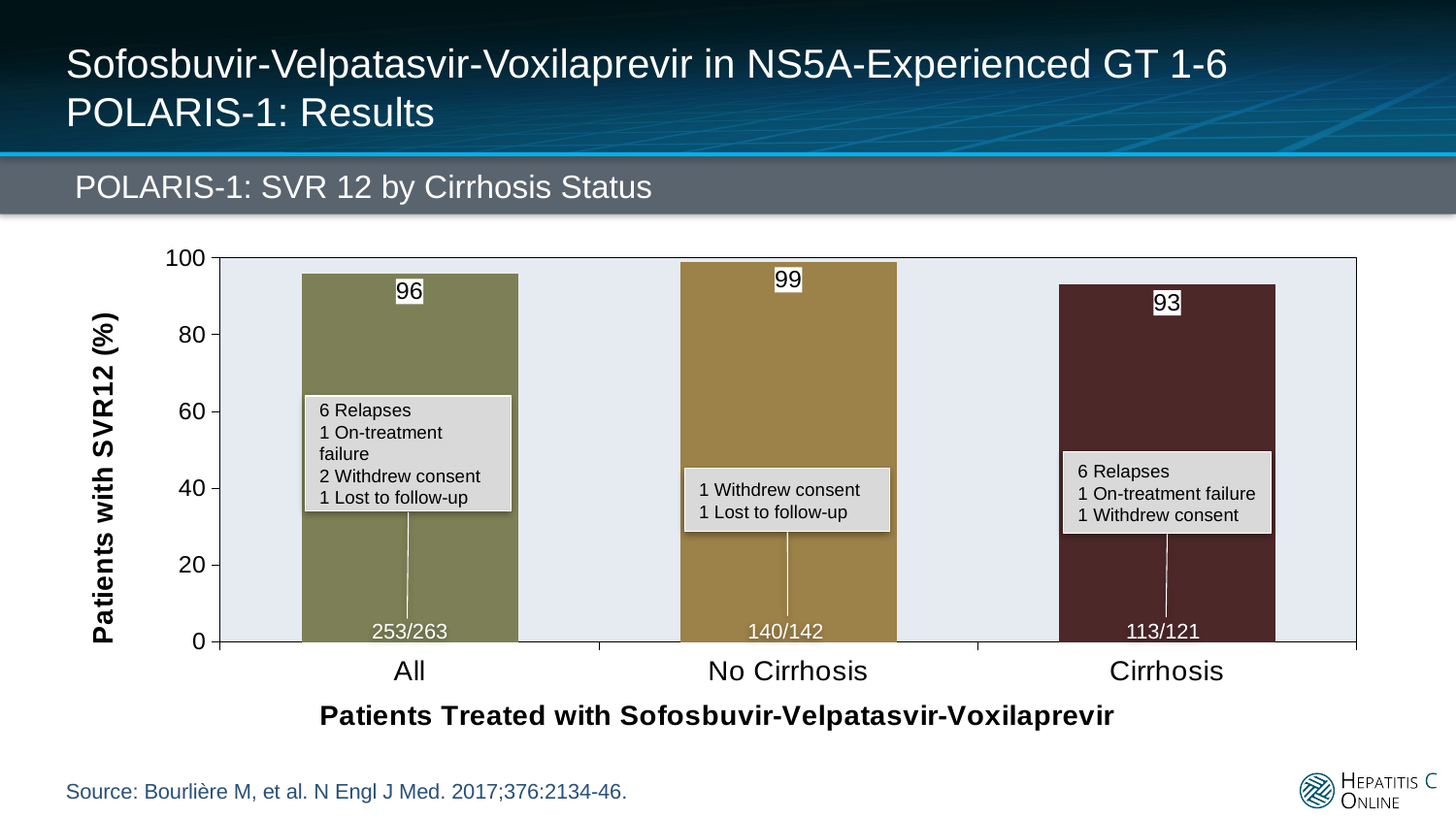
What is the difference in SVR12 rate between the No Cirrhosis and Cirrhosis groups? 6 What is the SVR12 rate for patients with No Cirrhosis? 99 What is the title of the chart? POLARIS-1: SVR 12 by Cirrhosis Status Which group has the lowest SVR12 rate? Cirrhosis What is the SVR12 rate for patients with Cirrhosis? 93 What is the SVR12 rate for the All group? 96 How many patient groups are shown on the x axis? 3 What type of chart is shown on the slide? Bar chart Which group has the highest SVR12 rate? No Cirrhosis Which group has a higher SVR12 rate, All or Cirrhosis? All What fraction of patients achieved SVR12 in the No Cirrhosis group? 140/142 What fraction of patients achieved SVR12 in the Cirrhosis group? 113/121